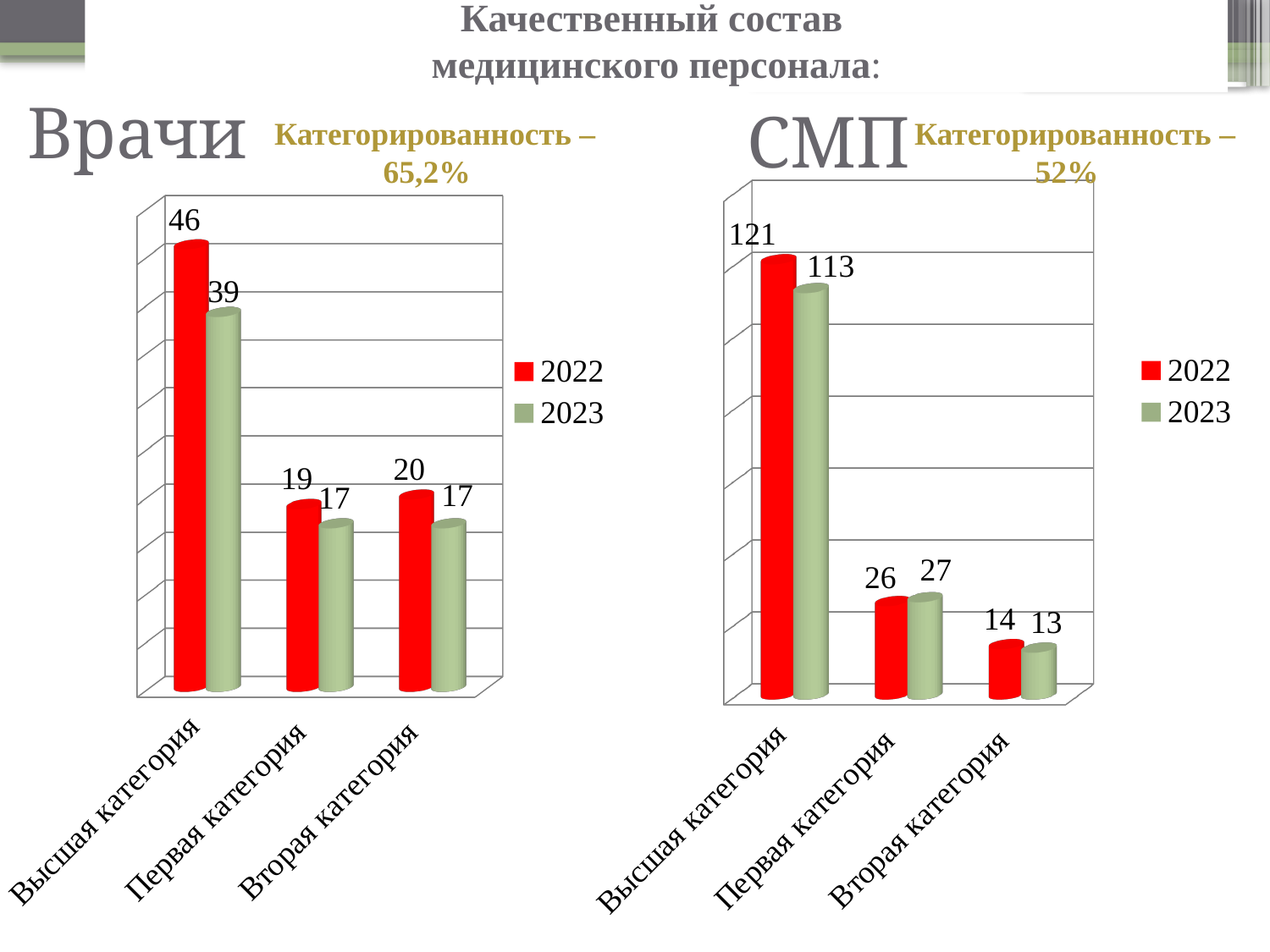
How many series does the legend of the СМП chart list? 2 In the СМП chart, which category has the lowest value for 2023? Вторая категория In the СМП chart, what is the value for Первая категория in 2022? 26 In the СМП chart, what is the value for Высшая категория in 2023? 113 How many categories are shown on the x axis of the Врачи chart? 3 What kind of chart is the Врачи chart? Bar chart In the СМП chart, which is larger for Первая категория: the 2022 value or the 2023 value? 2023 In the Врачи chart, what is the value for Вторая категория in 2023? 17 In the Врачи chart, what is the difference between the 2022 and 2023 values for Высшая категория? 7 In the СМП chart, what is the difference between the 2022 and 2023 values for Высшая категория? 8 In the Врачи chart, which category has the highest value for 2022? Высшая категория In the Врачи chart, what is the value for Высшая категория in 2022? 46